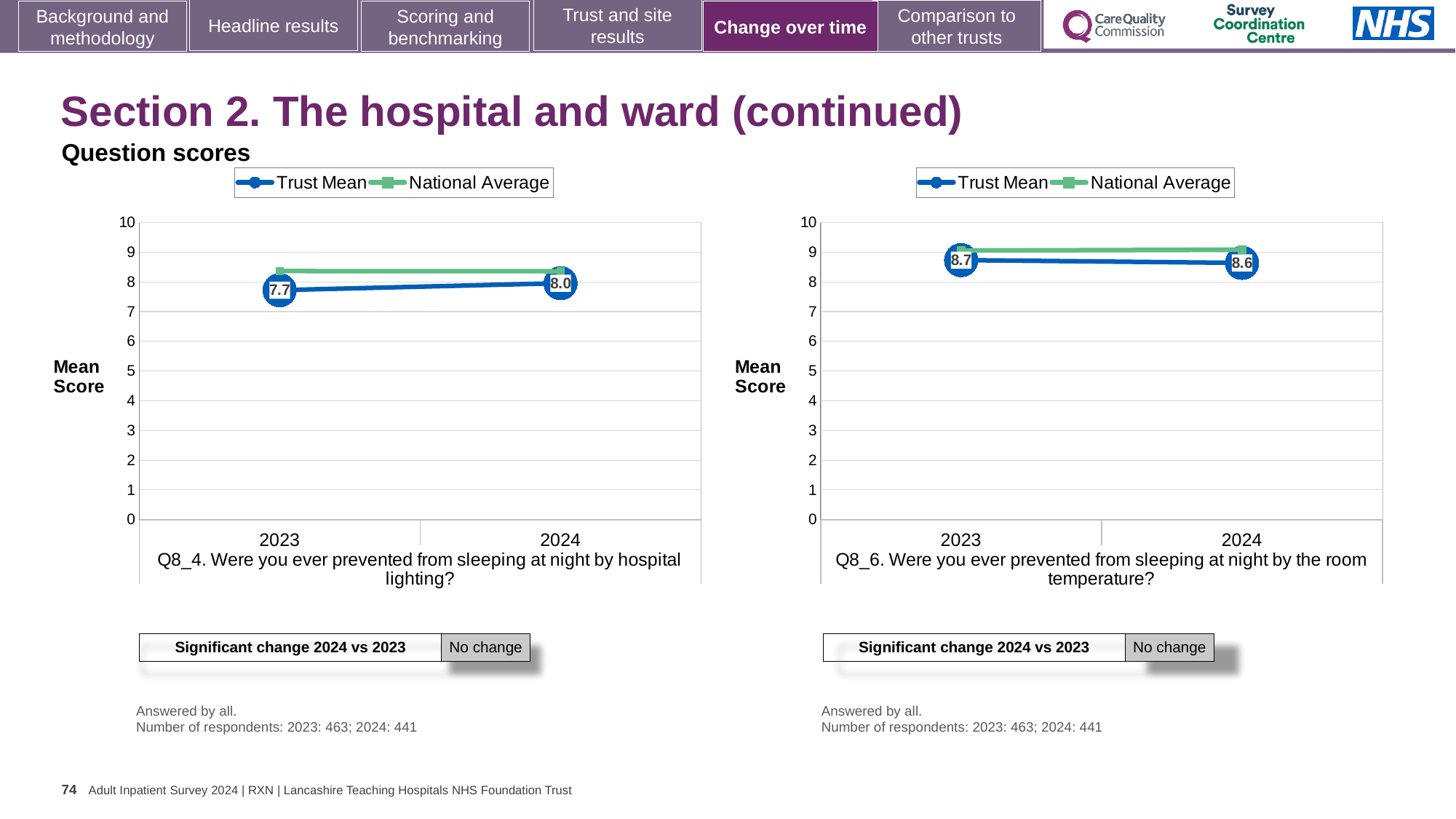
In the Q8_4 hospital lighting chart, what is the Trust Mean score for 2023? 7.7 In the Q8_4 hospital lighting chart, does the Trust Mean rise or fall from 2023 to 2024? rise In the Q8_6 room temperature chart, what is the Trust Mean score for 2023? 8.7 In the Q8_4 hospital lighting chart, by how much did the Trust Mean change from 2023 to 2024? 0.3 In the Q8_6 room temperature chart, does the Trust Mean rise or fall from 2023 to 2024? fall In the Q8_4 hospital lighting chart, is the National Average for 2023 greater or less than 8? greater In the Q8_4 hospital lighting chart, what is the Trust Mean score for 2024? 8.0 In the Q8_6 room temperature chart, what is the Trust Mean score for 2024? 8.6 How many years are plotted on the x axis of the Q8_4 hospital lighting chart? 2 In the Q8_6 room temperature chart, which is higher in 2024, the Trust Mean or the National Average? National Average How many series does the legend list in the Q8_6 room temperature chart? 2 What kind of chart is used for the Q8_4 hospital lighting question? line chart